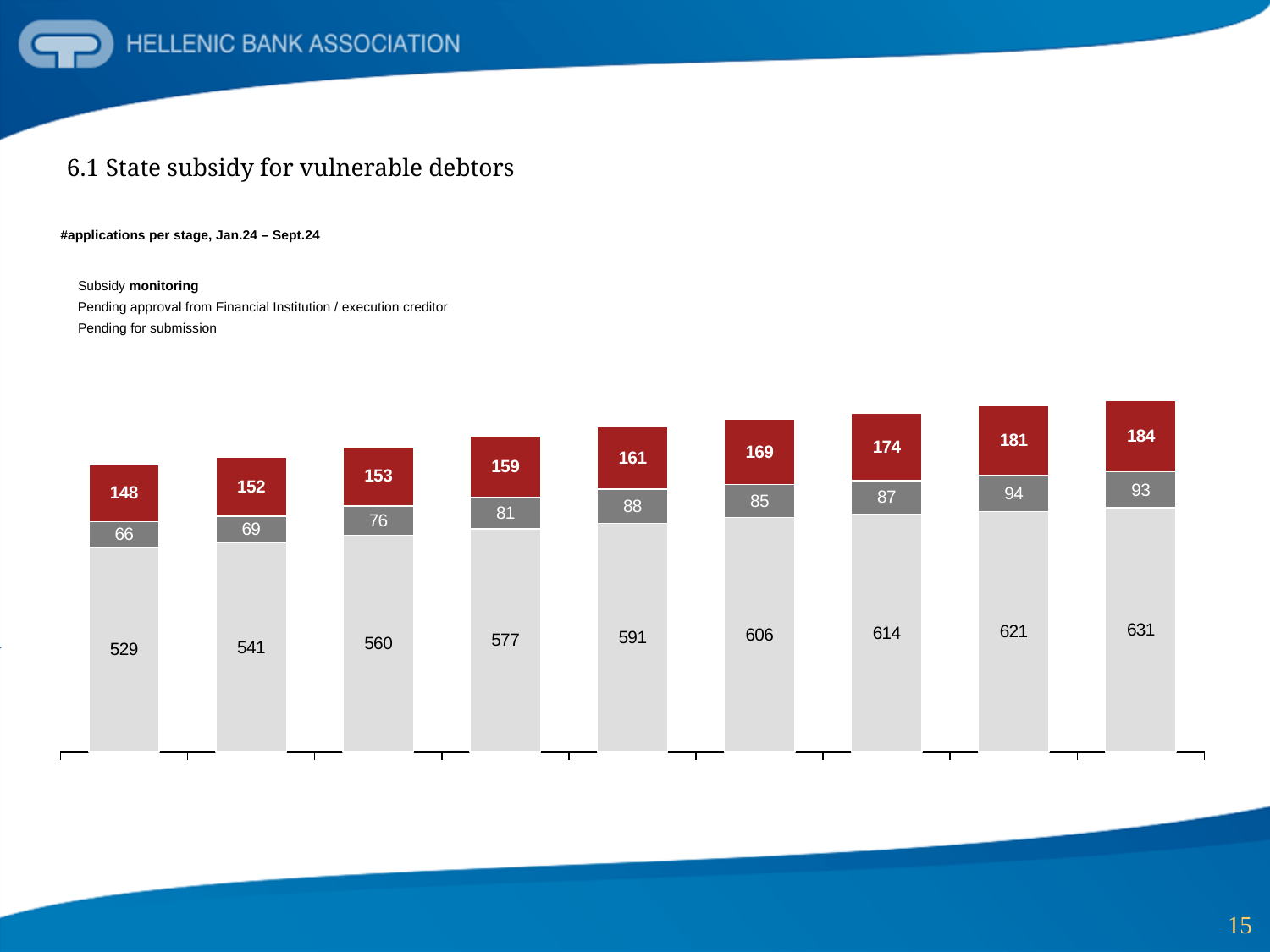
Which is larger: the red segment of the fifth bar (161) or the red segment of the sixth bar (169)? The sixth bar (169) What is the difference between the bottom segment of the rightmost bar (631) and the bottom segment of the leftmost bar (529)? 102 Do the values of the light grey (bottom) segments rise or fall from left to right across the bars? Rise What is the total of the rightmost stacked bar (631 + 93 + 184)? 908 How many bars are plotted in the chart? 9 What is the value of the red (top) segment of the leftmost bar? 148 What is the value of the dark grey (middle) segment of the fourth bar from the left? 81 What kind of chart is shown on the slide? Stacked bar chart Which bar has the largest light grey (bottom) segment? The rightmost bar (631) How many series does the legend list? 3 What is the total of the leftmost stacked bar (529 + 66 + 148)? 743 What is the value of the light grey (bottom) segment of the rightmost bar? 631